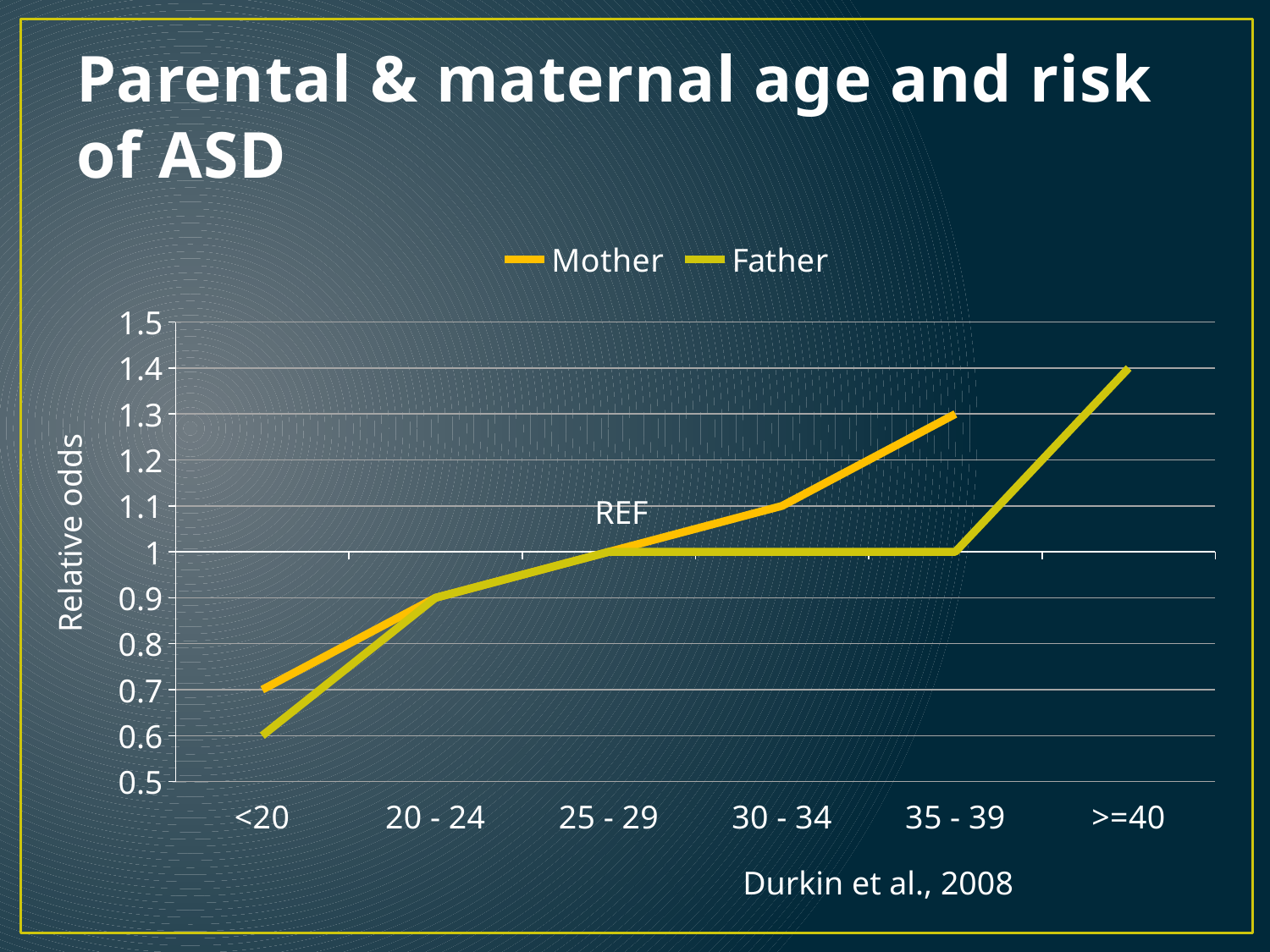
Which age group is labelled REF on the chart? 25 - 29 Which age group has the lowest relative odds for Father? <20 Do the relative odds for Father generally rise or fall as parental age increases along the x axis? Rise Which age group has the highest relative odds for Mother? 35 - 39 What is the relative odds for Father in the >=40 age group? 1.4 How many age categories are shown on the x axis? 6 In the <20 age group, which series has the higher relative odds, Mother or Father? Mother What kind of chart is shown on the slide? Line chart What is the relative odds for Mother in the <20 age group? 0.7 How many series does the legend list? 2 What is the relative odds for Mother in the 35 - 39 age group? 1.3 What is the relative odds for Father in the <20 age group? 0.6